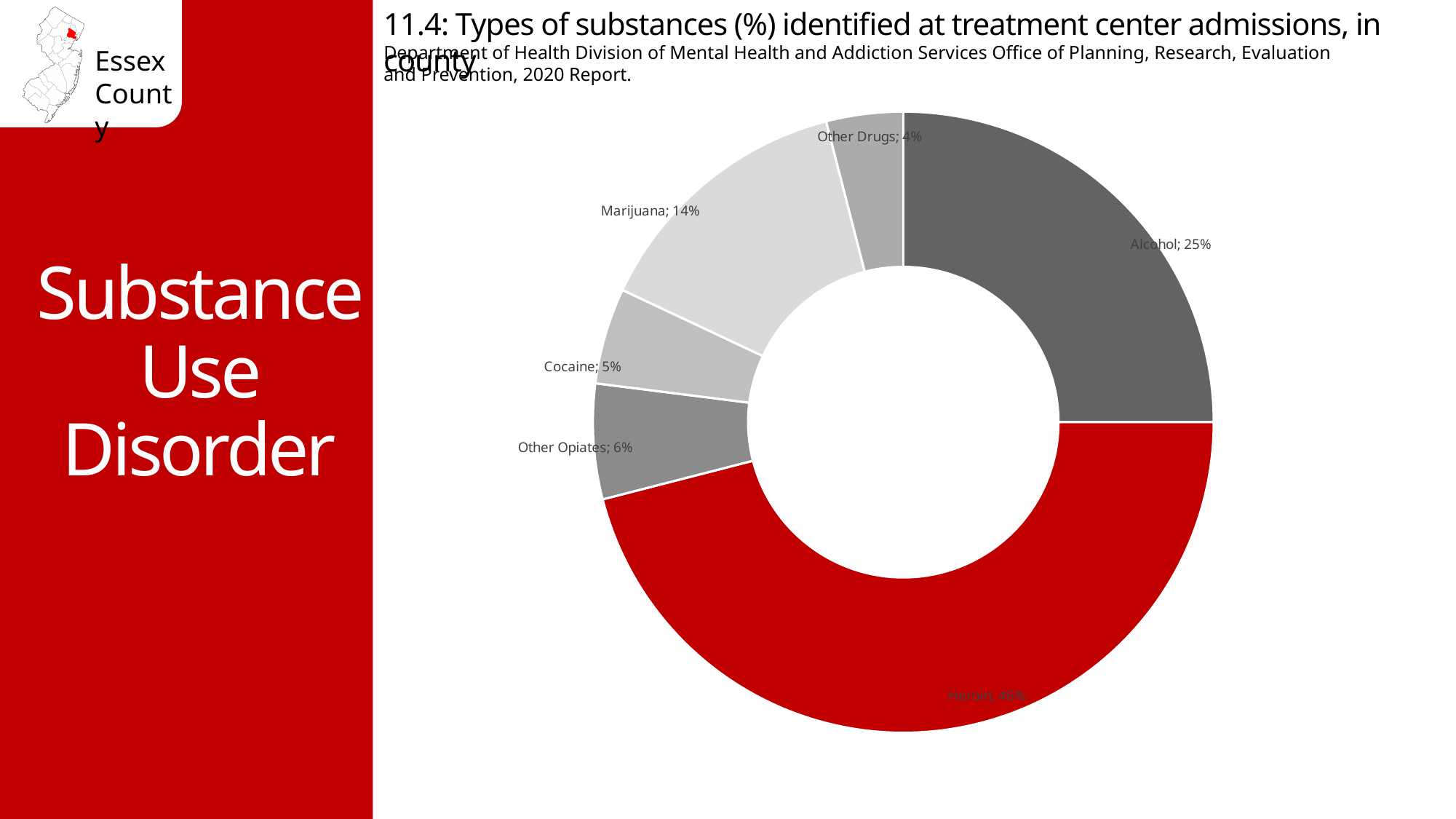
What percentage of treatment center admissions is attributed to Cocaine? 5% How many substance categories are shown in the chart? 6 Which substance accounts for the largest share of treatment center admissions? Heroin What is the difference in percentage points between Alcohol and Marijuana? 11 What percentage of treatment center admissions is attributed to Other Opiates? 6% Which slice of the chart is coloured red? Heroin Which has a larger share of admissions, Cocaine or Other Opiates? Other Opiates What kind of chart is used on this slide? Doughnut chart What percentage of treatment center admissions is attributed to Marijuana? 14% Which substance accounts for the smallest share of treatment center admissions? Other Drugs What percentage of treatment center admissions is attributed to Other Drugs? 4% What percentage of treatment center admissions is attributed to Alcohol? 25%